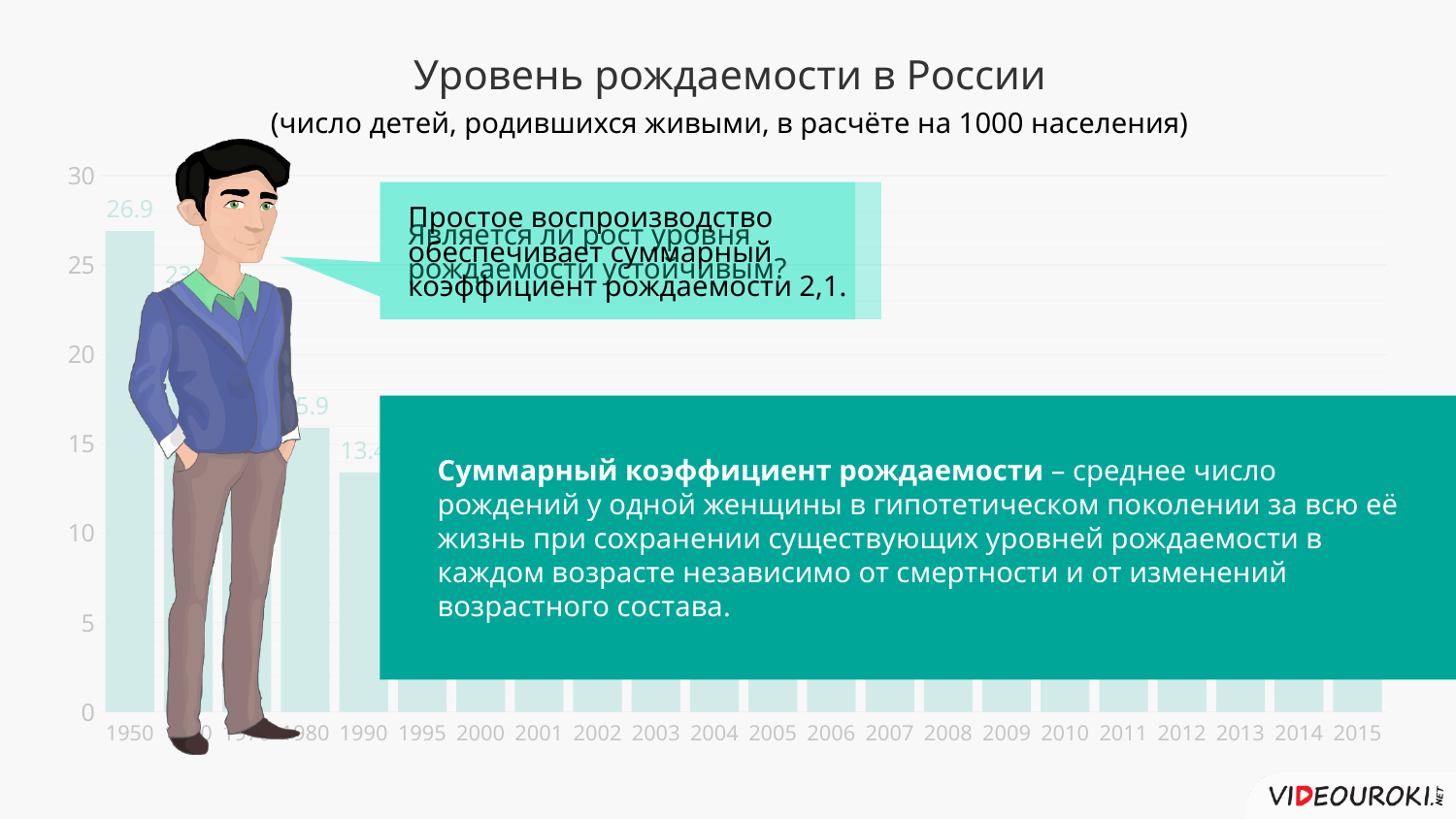
Which year has the highest bar in the chart? 1950 What kind of chart is shown on the slide? bar chart What is the title of the chart? Уровень рождаемости в России Which is larger, the value for 1950 or the value for 1990? 1950 What is the birth rate value shown for 1950? 26.9 Is the value for 1990 greater or less than 15? less Do the values rise or fall from 1950 to 1990? fall Is the value for 1950 greater or less than 25? greater Is the value for 1980 greater or less than 15? greater What is the last year shown on the horizontal axis? 2015 What is the highest tick value shown on the vertical axis? 30